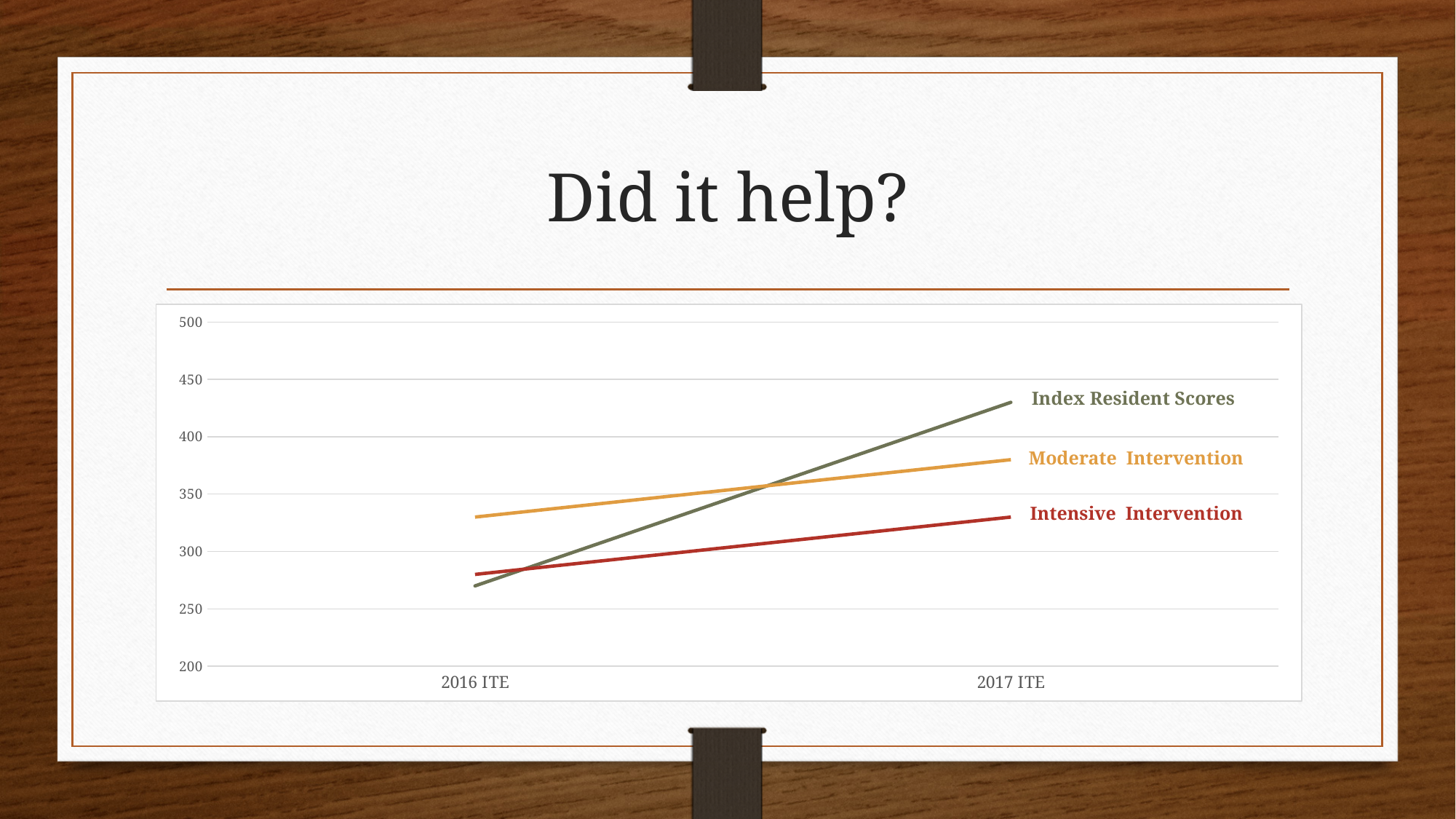
Is the value for Index Resident Scores at 2017 ITE greater or less than 400? greater Is the value for Moderate Intervention at 2017 ITE greater or less than 400? less What is the title of the slide containing the chart? Did it help? Which series has the highest value at 2016 ITE? Moderate Intervention How many series are plotted on the chart? 3 Is the value for Intensive Intervention at 2016 ITE greater or less than 300? less Do the Index Resident Scores rise or fall from 2016 ITE to 2017 ITE? rise At 2016 ITE, which is larger: Moderate Intervention or Intensive Intervention? Moderate Intervention Which series has the lowest value at 2017 ITE? Intensive Intervention What kind of chart is shown on the slide? line chart Which series has the highest value at 2017 ITE? Index Resident Scores How many points are on the x axis of the chart? 2